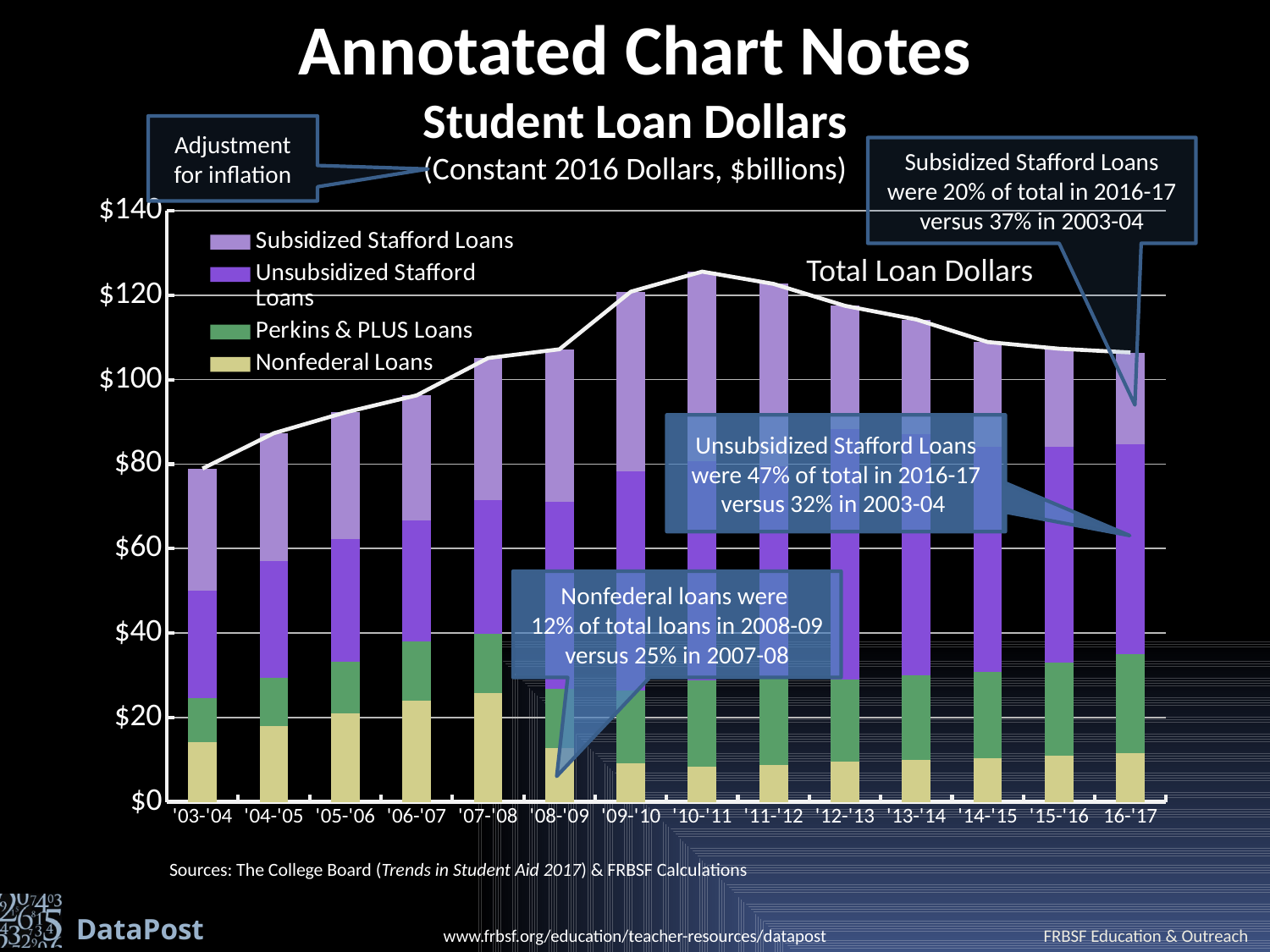
How many academic years are shown along the x axis of the Student Loan Dollars chart? 14 How many series does the legend of the Student Loan Dollars chart list? 4 In which academic year is Total Loan Dollars lowest? '03-'04 What units are stated in the subtitle of the Student Loan Dollars chart? Constant 2016 Dollars, $billions In which academic year is Total Loan Dollars highest? '10-'11 Which year has larger Total Loan Dollars, '03-'04 or '09-'10? '09-'10 Is Total Loan Dollars for '10-'11 greater or less than $120? greater From '10-'11 to '16-'17, does Total Loan Dollars rise or fall? fall According to the annotation, what share of total loans were Unsubsidized Stafford Loans in 2016-17? 47% Is Total Loan Dollars for '05-'06 greater or less than $100? less What kind of chart is shown on the slide? Stacked bar chart with a line Is Total Loan Dollars for '16-'17 greater or less than $100? greater